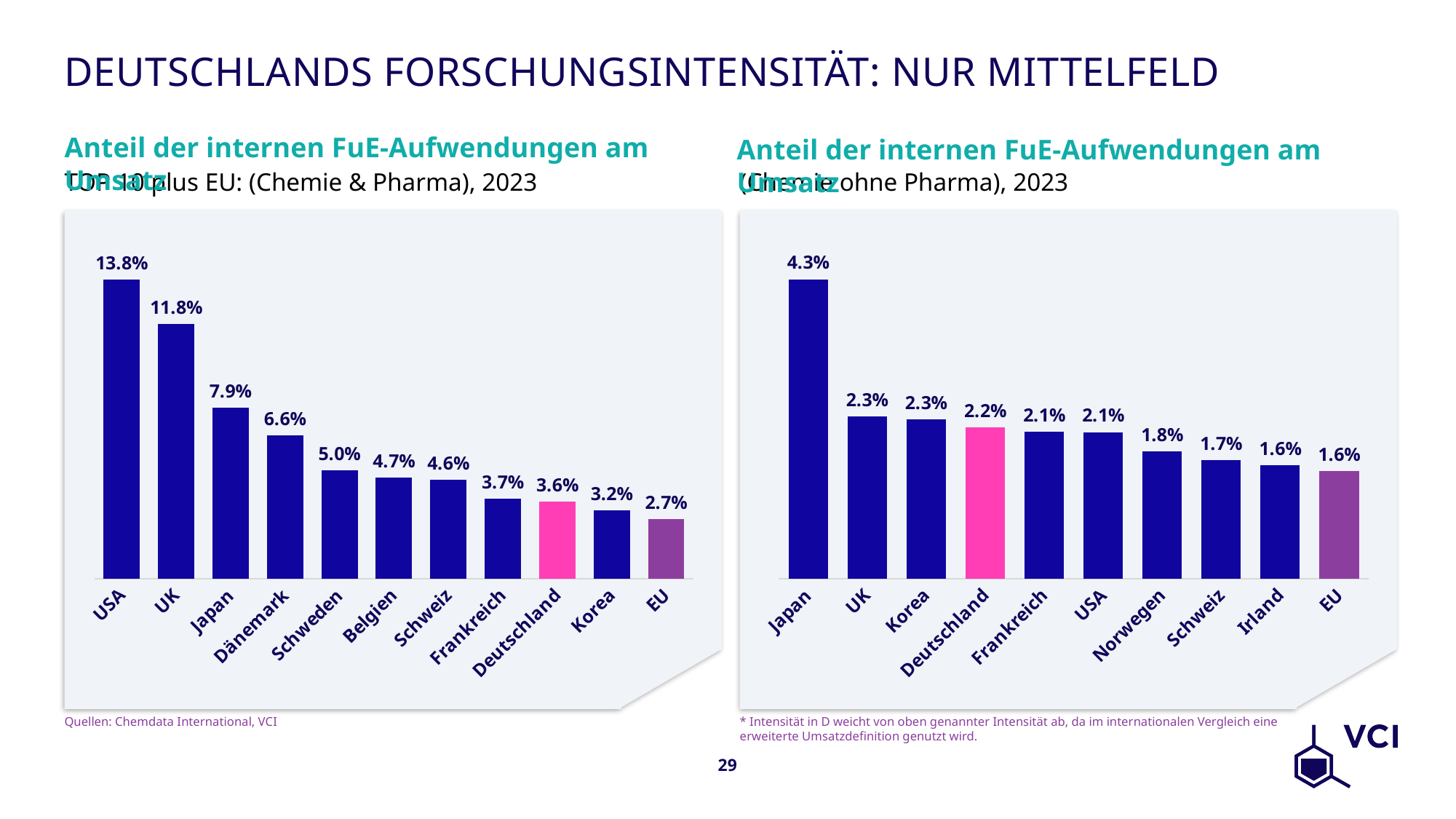
In the right chart (Chemie ohne Pharma, 2023), how many bars are shown? 10 In the left chart (Chemie & Pharma, 2023), how many bars are shown? 11 In the left chart (Chemie & Pharma, 2023), which country has the highest value? USA In the right chart (Chemie ohne Pharma, 2023), what is the difference between the values for Japan and Deutschland? 2.1% In the left chart (Chemie & Pharma, 2023), what is the value for Deutschland? 3.6% What type of chart is the right chart (Chemie ohne Pharma, 2023)? Bar chart In the right chart (Chemie ohne Pharma, 2023), what is the value for Deutschland? 2.2% In the left chart (Chemie & Pharma, 2023), which is larger, the value for Japan or the value for Dänemark? Japan In the left chart (Chemie & Pharma, 2023), which category has the lowest value? EU In the right chart (Chemie ohne Pharma, 2023), what is the value for Japan? 4.3% In the left chart (Chemie & Pharma, 2023), which bar is highlighted in pink? Deutschland In the left chart (Chemie & Pharma, 2023), what is the difference between the values for USA and UK? 2.0%